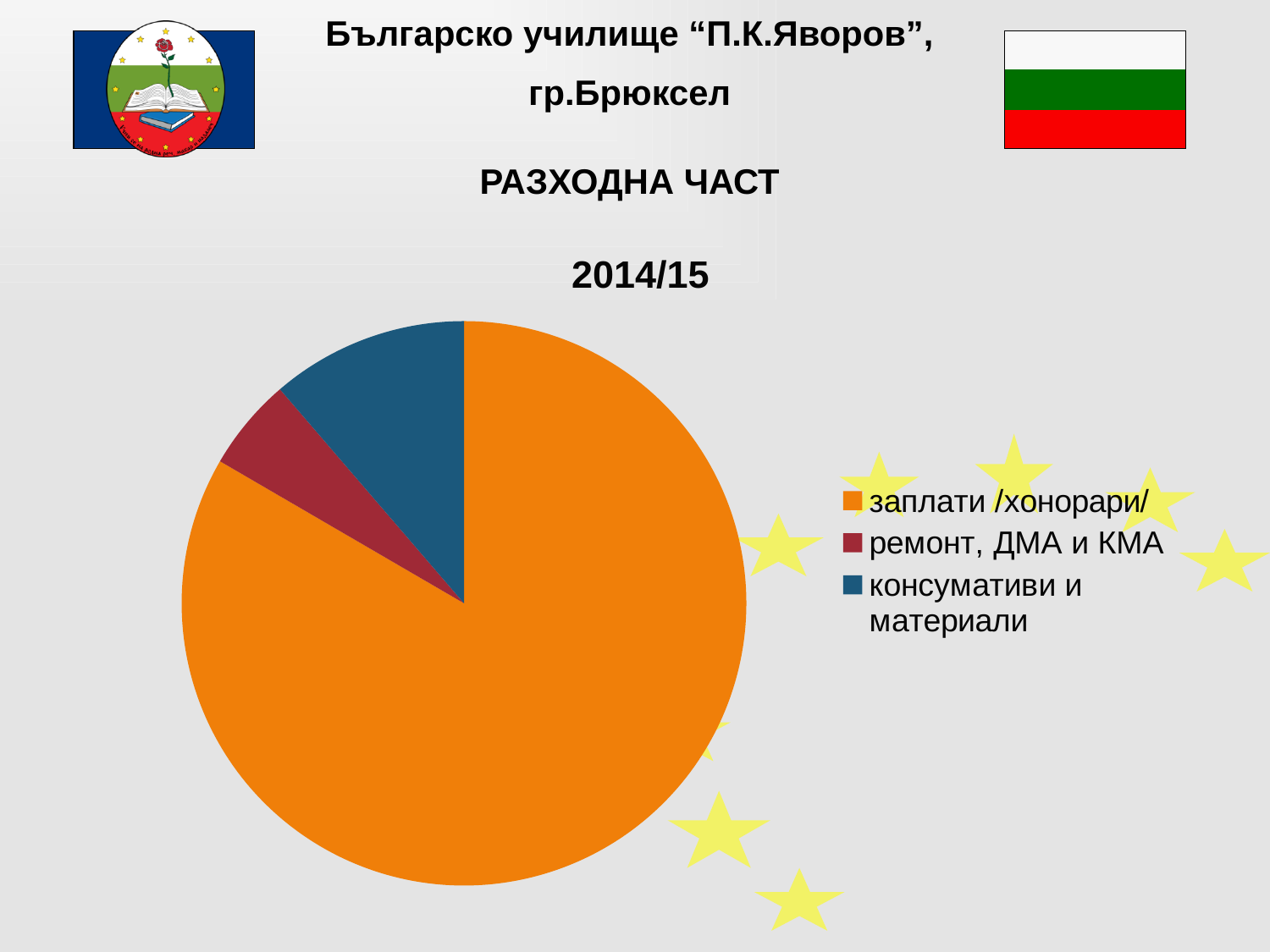
How many entries does the legend of the pie chart list? 3 Which slice is larger: заплати /хонорари/ or консумативи и материали? заплати /хонорари/ What is the title shown directly above the pie chart? 2014/15 Which category has the largest slice of the pie chart? заплати /хонорари/ What colour is the slice for заплати /хонорари/ in the pie chart? orange How many slices does the pie chart have? 3 Which category has the smallest slice of the pie chart? ремонт, ДМА и КМА Which slice is larger: консумативи и материали or ремонт, ДМА и КМА? консумативи и материали What kind of chart is shown on the slide? pie chart